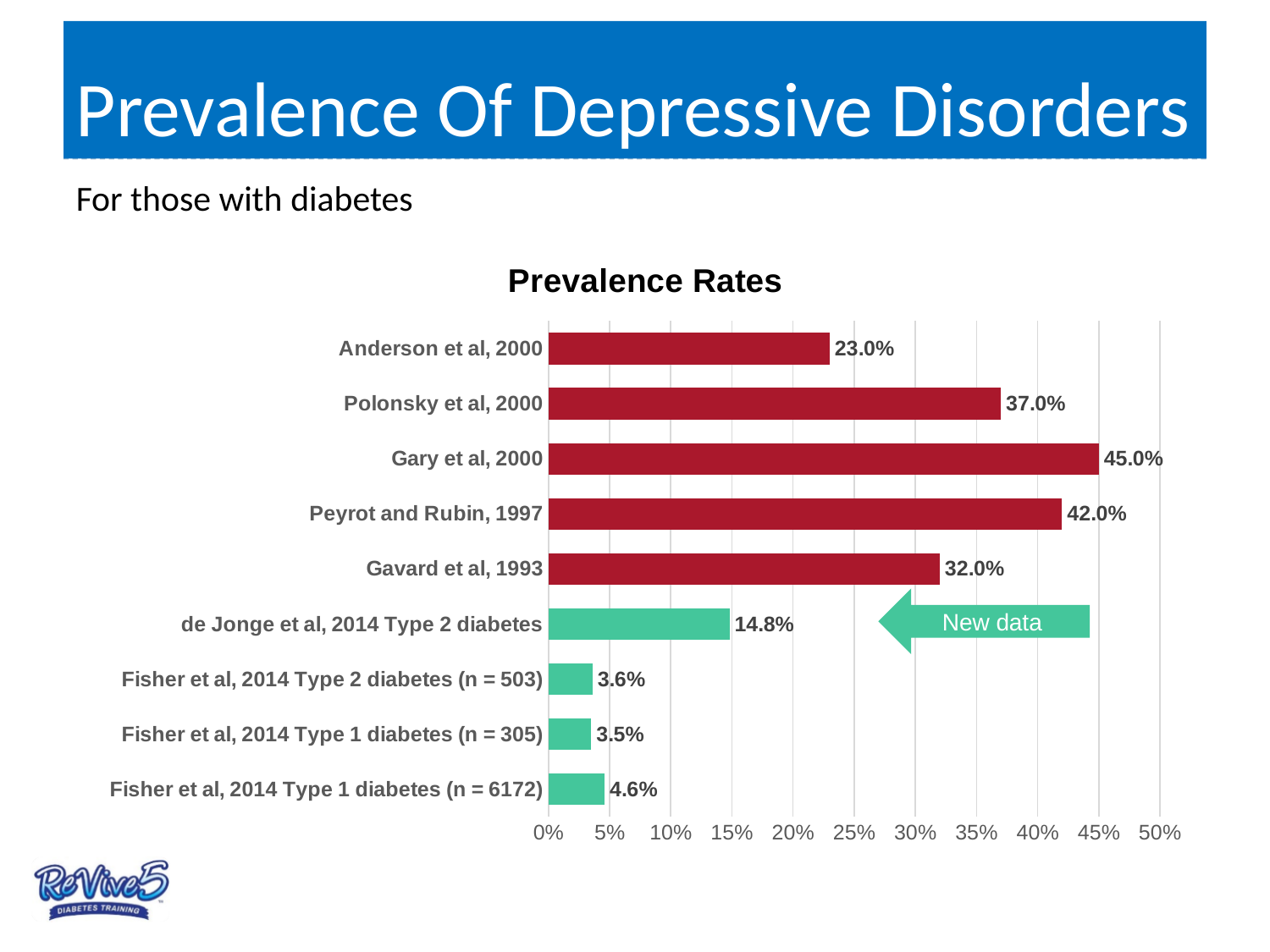
What is the prevalence rate for Fisher et al, 2014 Type 1 diabetes (n = 6172)? 4.6% What is the prevalence rate for de Jonge et al, 2014 Type 2 diabetes? 14.8% What is the prevalence rate for Gary et al, 2000? 45.0% Which study has the lowest prevalence rate? Fisher et al, 2014 Type 1 diabetes (n = 305) What is the title of the chart? Prevalence Rates How many studies are shown in the chart? 9 What kind of chart is shown on the slide? Bar chart What does the arrow label pointing at the de Jonge et al, 2014 bar say? New data What is the difference between the prevalence rates for Peyrot and Rubin, 1997 and Gavard et al, 1993? 10.0% Is the value for Gavard et al, 1993 greater or less than 30%? greater Which study has the highest prevalence rate? Gary et al, 2000 Which has a higher prevalence rate, Polonsky et al, 2000 or Anderson et al, 2000? Polonsky et al, 2000